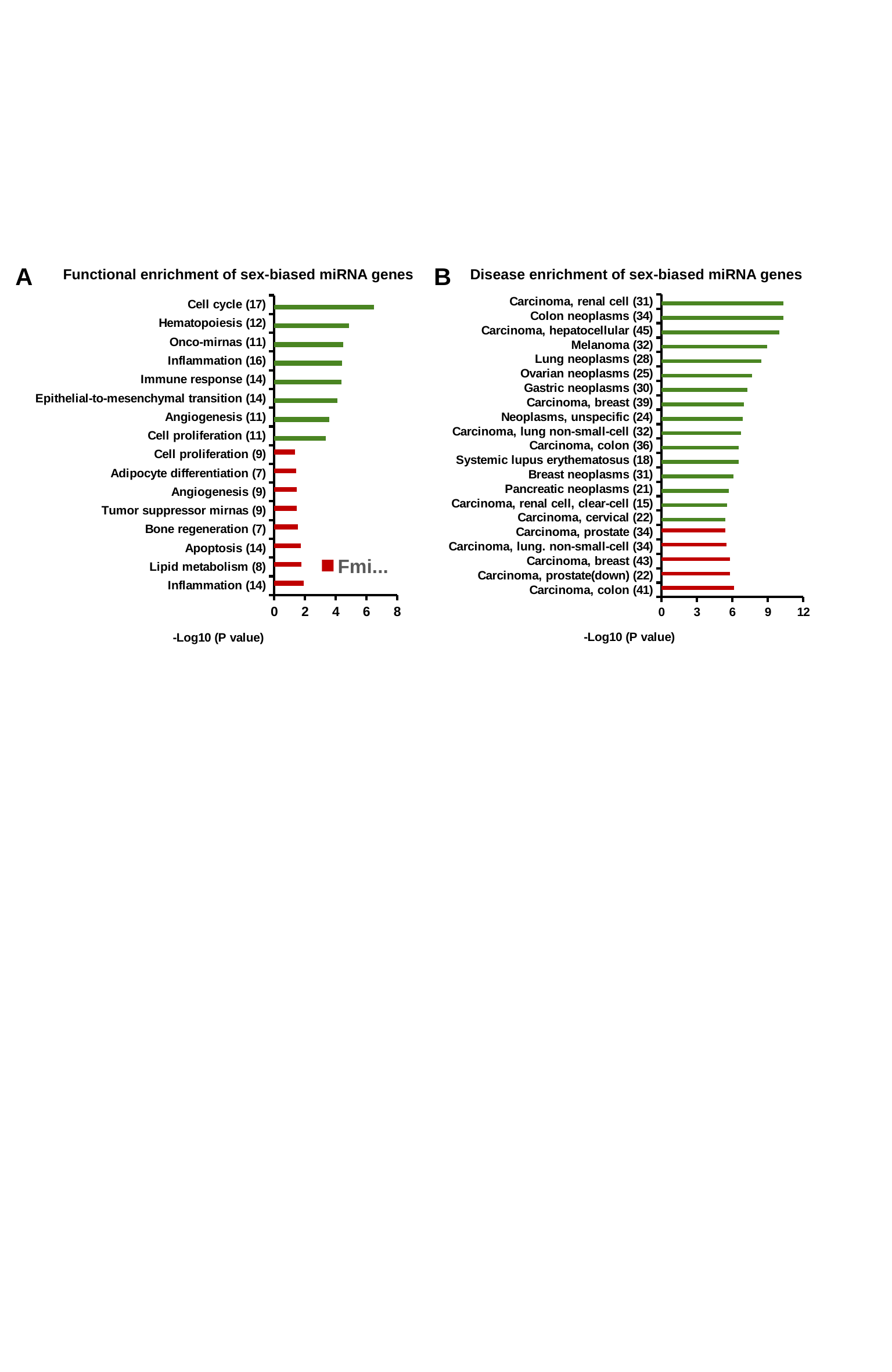
In the 'Functional enrichment of sex-biased miRNA genes' chart, how many categories are plotted? 16 In the 'Disease enrichment of sex-biased miRNA genes' chart, how many categories are plotted? 21 What kind of chart is the 'Functional enrichment of sex-biased miRNA genes' chart? bar chart In the 'Disease enrichment of sex-biased miRNA genes' chart, which is larger: Carcinoma, hepatocellular (45) or Melanoma (32)? Carcinoma, hepatocellular (45) What is the x-axis label of the 'Disease enrichment of sex-biased miRNA genes' chart? -Log10 (P value) In the 'Disease enrichment of sex-biased miRNA genes' chart, is the value for Carcinoma, cervical (22) greater or less than 6? less In the 'Disease enrichment of sex-biased miRNA genes' chart, is the value for Carcinoma, renal cell (31) greater or less than 9? greater In the 'Functional enrichment of sex-biased miRNA genes' chart, which is larger: Onco-mirnas (11) or Cell proliferation (11)? Onco-mirnas (11) In the 'Functional enrichment of sex-biased miRNA genes' chart, which category has the highest value? Cell cycle (17) In the 'Functional enrichment of sex-biased miRNA genes' chart, is the value for Cell cycle (17) greater or less than 6? greater In the 'Disease enrichment of sex-biased miRNA genes' chart, which is larger: Lung neoplasms (28) or Carcinoma, breast (39)? Lung neoplasms (28)